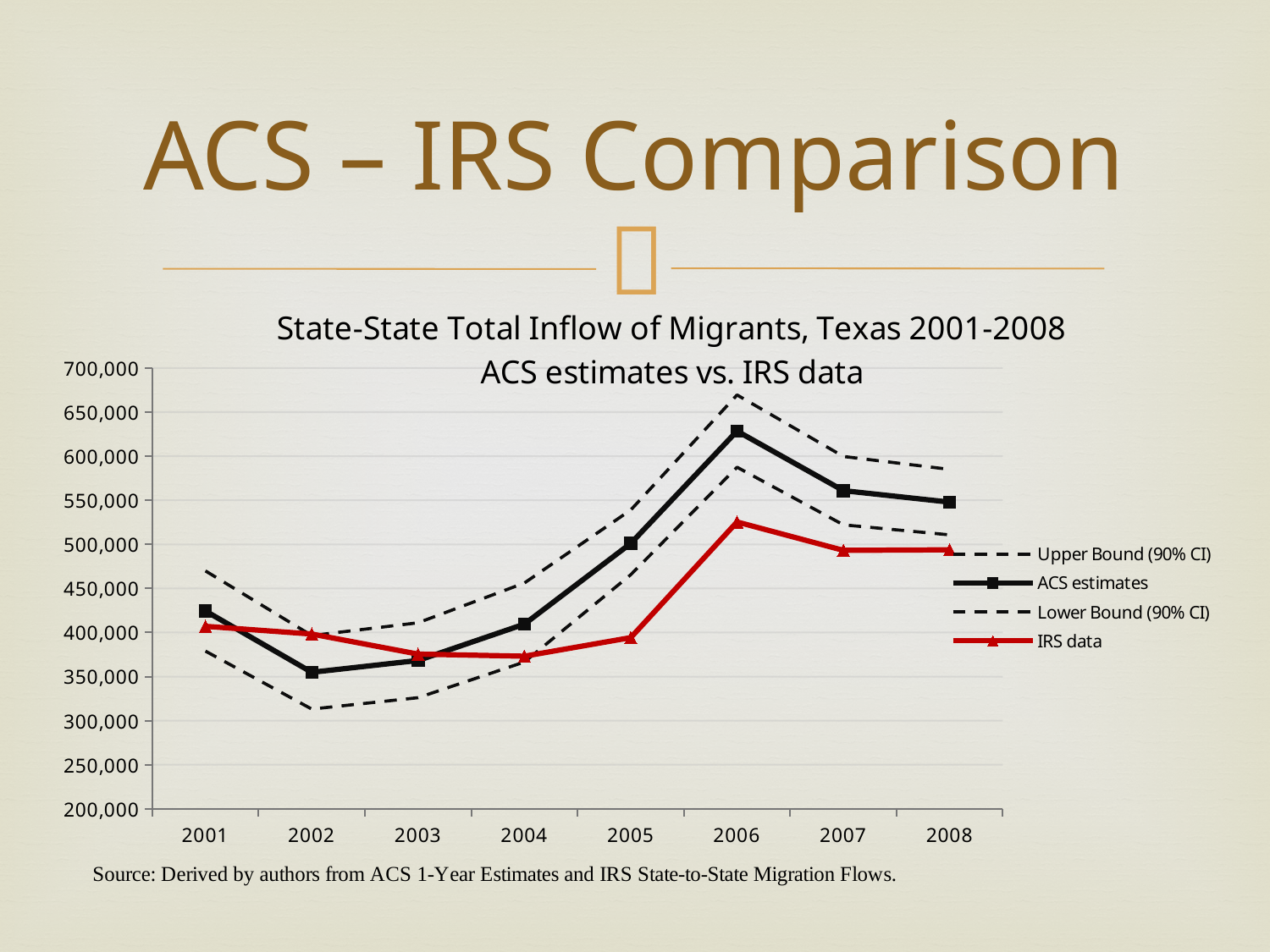
Is the ACS estimate for 2002 greater or less than 400,000? less In which year do the ACS estimates reach their lowest value? 2002 How many series does the legend list? 4 In 2006, which is larger: the ACS estimate or the IRS data value? ACS estimate Do the ACS estimates rise or fall from 2006 to 2008? fall In which year does the IRS data reach its highest value? 2006 What kind of chart is shown on the slide? line chart Is the ACS estimate for 2006 greater or less than 600,000? greater In 2002, which is larger: the ACS estimate or the IRS data value? IRS data How many years are plotted along the x axis? 8 In which year do the ACS estimates reach their highest value? 2006 Is the IRS data value for 2006 greater or less than 500,000? greater